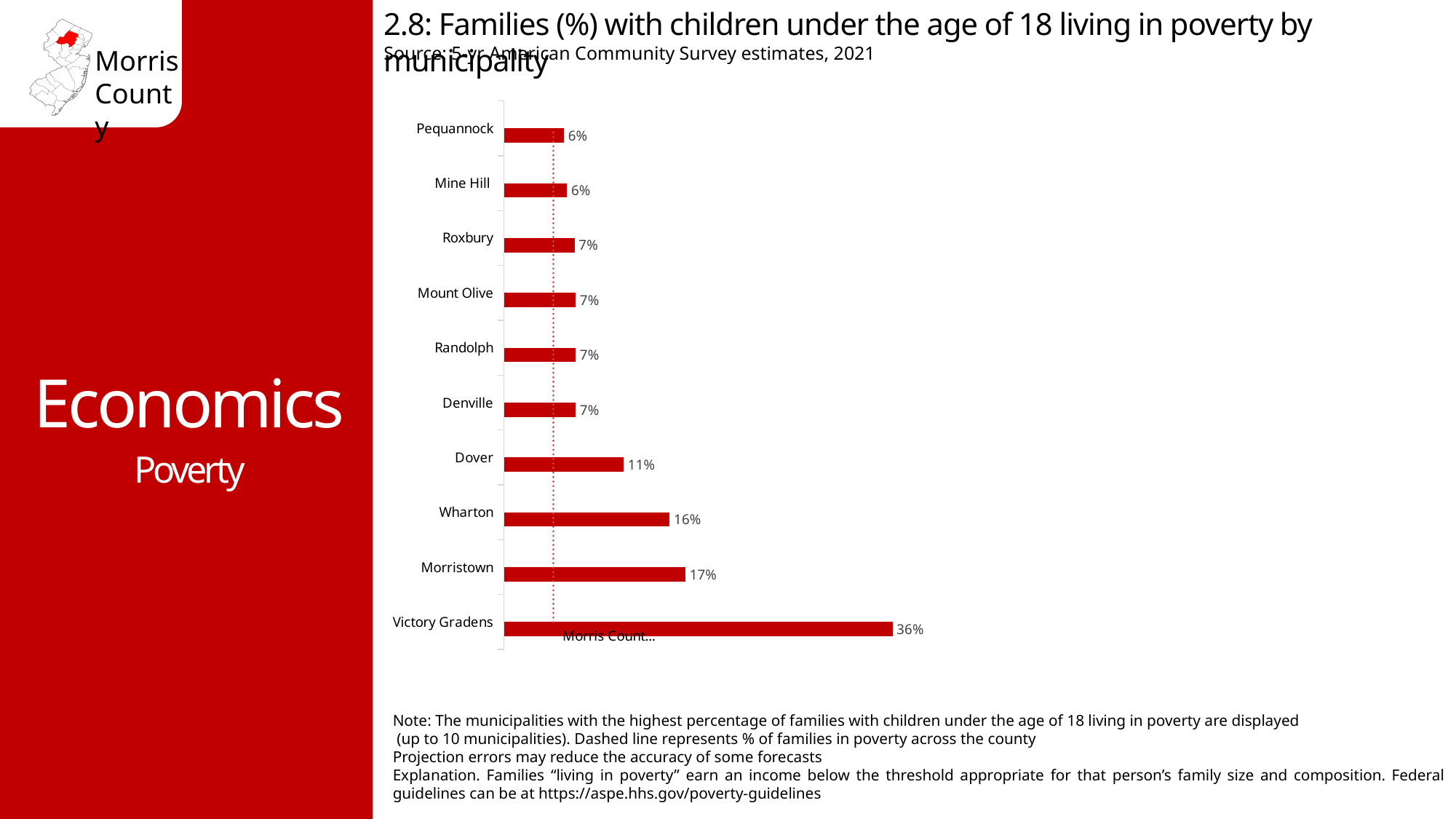
Which municipality has the highest percentage of families with children under 18 living in poverty? Victory Gardens Which is larger, the value for Morristown or the value for Dover? Morristown What is the difference between the values for Victory Gardens and Morristown? 19% What is the difference between the values for Wharton and Dover? 5% What kind of chart is shown on the slide? Bar chart Which is larger, the value for Roxbury or the value for Wharton? Wharton What does the dashed vertical line in the chart represent? % of families in poverty across the county What is the value for Morristown? 17% What is the value for Dover? 11% What is the value for Wharton? 16% How many municipalities are shown in the chart? 10 What is the value for Victory Gardens? 36%